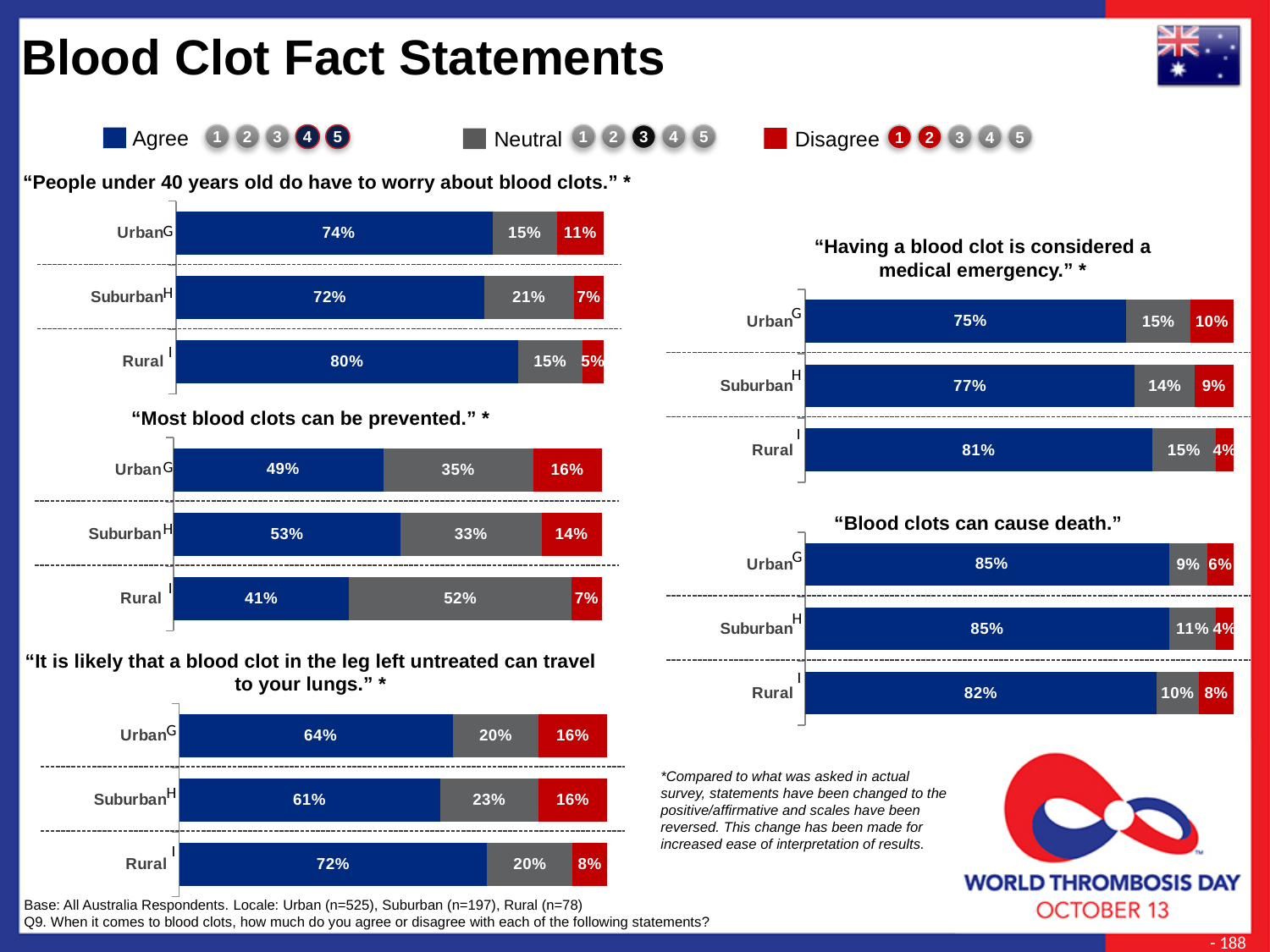
In the chart "Having a blood clot is considered a medical emergency.", which locale has the highest Agree percentage? Rural Which colour represents Disagree in the charts on this slide? Red In the chart "Most blood clots can be prevented.", which locale has the lowest Agree percentage? Rural In the chart "People under 40 years old do have to worry about blood clots.", what percentage of Rural respondents agree? 80% In the chart "People under 40 years old do have to worry about blood clots.", which is larger: the Neutral percentage for Suburban or for Urban? Suburban How many locale categories are shown in the chart "Having a blood clot is considered a medical emergency."? 3 How many series does the legend at the top of the slide list? 3 In the chart "Blood clots can cause death.", what is the Disagree percentage for Suburban respondents? 4% In the chart "Blood clots can cause death.", what is the total of the Urban stacked bar (Agree + Neutral + Disagree)? 100% In the chart "It is likely that a blood clot in the leg left untreated can travel to your lungs.", what is the difference between the Rural and Suburban Agree percentages? 11% In the chart "Most blood clots can be prevented.", what is the Neutral percentage for Rural respondents? 52% What type of chart is used for "Most blood clots can be prevented."? Stacked bar chart